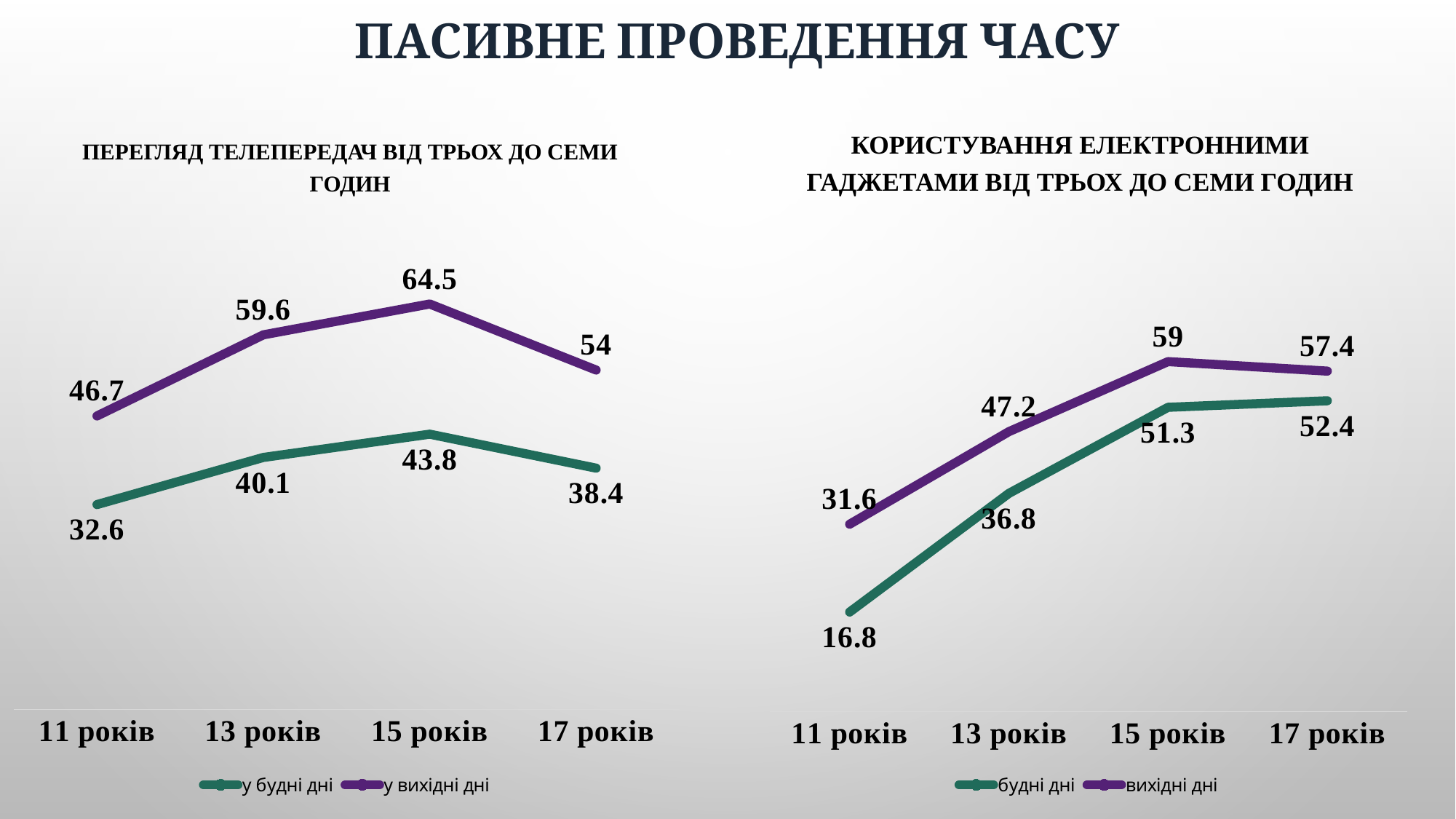
In the left chart (ПЕРЕГЛЯД ТЕЛЕПЕРЕДАЧ), what is the value for 'у будні дні' at 11 років? 32.6 In the right chart (КОРИСТУВАННЯ ЕЛЕКТРОННИМИ ГАДЖЕТАМИ), what is the difference between 'вихідні дні' and 'будні дні' at 11 років? 14.8 In the left chart (ПЕРЕГЛЯД ТЕЛЕПЕРЕДАЧ), how many series does the legend list? 2 In the left chart (ПЕРЕГЛЯД ТЕЛЕПЕРЕДАЧ), what is the value for 'у вихідні дні' at 15 років? 64.5 In the right chart (КОРИСТУВАННЯ ЕЛЕКТРОННИМИ ГАДЖЕТАМИ), which is larger at 13 років: 'будні дні' or 'вихідні дні'? вихідні дні In the left chart (ПЕРЕГЛЯД ТЕЛЕПЕРЕДАЧ), what is the difference between 'у вихідні дні' and 'у будні дні' at 17 років? 15.6 In the left chart (ПЕРЕГЛЯД ТЕЛЕПЕРЕДАЧ), what kind of chart is shown? line chart In the right chart (КОРИСТУВАННЯ ЕЛЕКТРОННИМИ ГАДЖЕТАМИ), what is the value for 'вихідні дні' at 15 років? 59 In the right chart (КОРИСТУВАННЯ ЕЛЕКТРОННИМИ ГАДЖЕТАМИ), what is the value for 'будні дні' at 11 років? 16.8 In the left chart (ПЕРЕГЛЯД ТЕЛЕПЕРЕДАЧ), at which age is the 'у будні дні' value highest? 15 років In the right chart (КОРИСТУВАННЯ ЕЛЕКТРОННИМИ ГАДЖЕТАМИ), at which age is the 'будні дні' value lowest? 11 років In the right chart (КОРИСТУВАННЯ ЕЛЕКТРОННИМИ ГАДЖЕТАМИ), how many age categories are shown on the x axis? 4